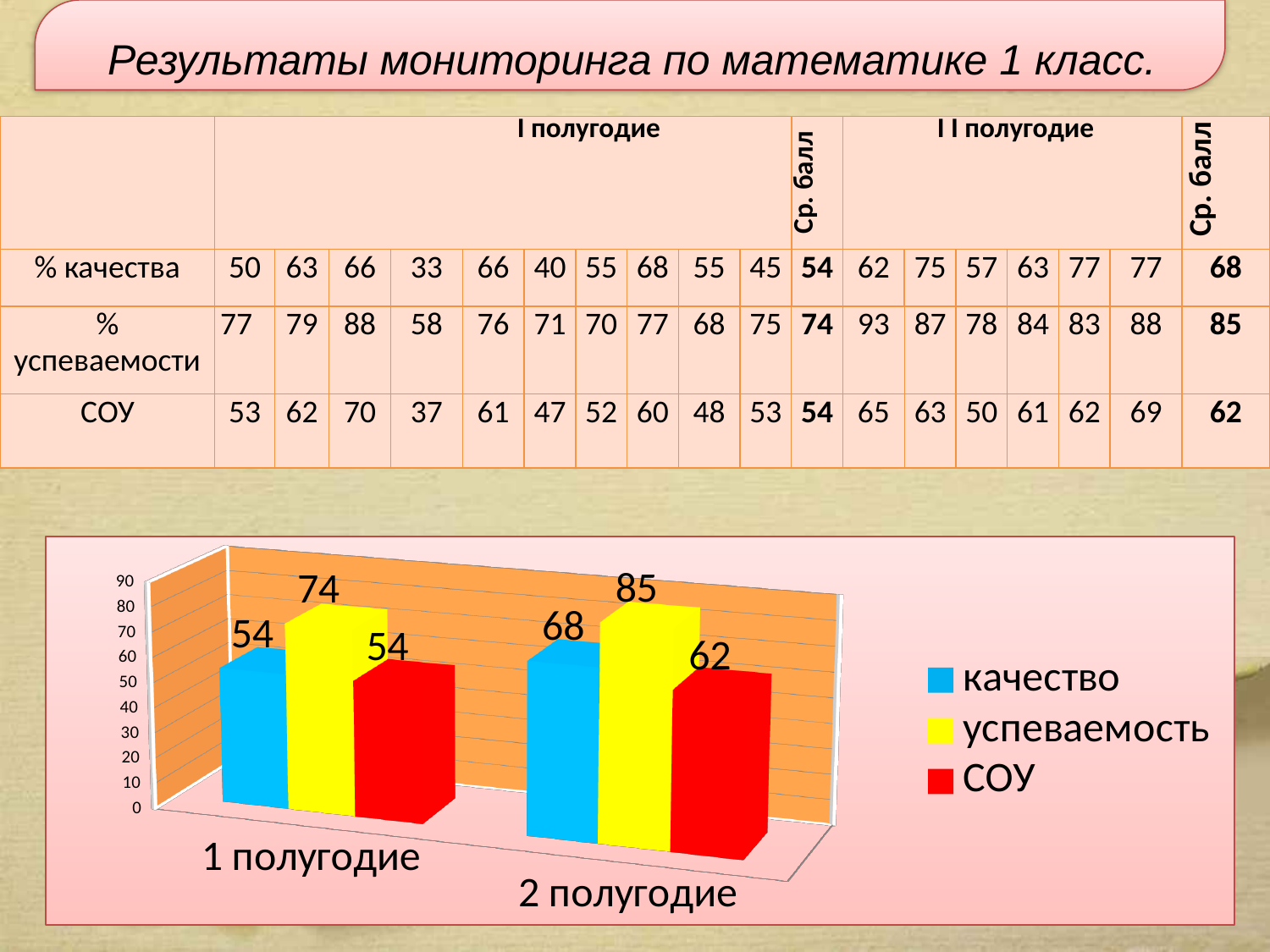
How many series does the legend list? 3 Which colour represents СОУ in the chart? red What is the difference between качество and СОУ in 2 полугодие? 6 Which series has the highest value for 2 полугодие? успеваемость Which is larger: качество in 1 полугодие or качество in 2 полугодие? качество in 2 полугодие How many categories are shown on the x axis? 2 What kind of chart is shown on the slide? bar chart What is the value of СОУ for 2 полугодие? 62 What is the difference between успеваемость in 2 полугодие and успеваемость in 1 полугодие? 11 What is the value of СОУ for 1 полугодие? 54 What is the value of качество for 2 полугодие? 68 What is the value of успеваемость for 1 полугодие? 74